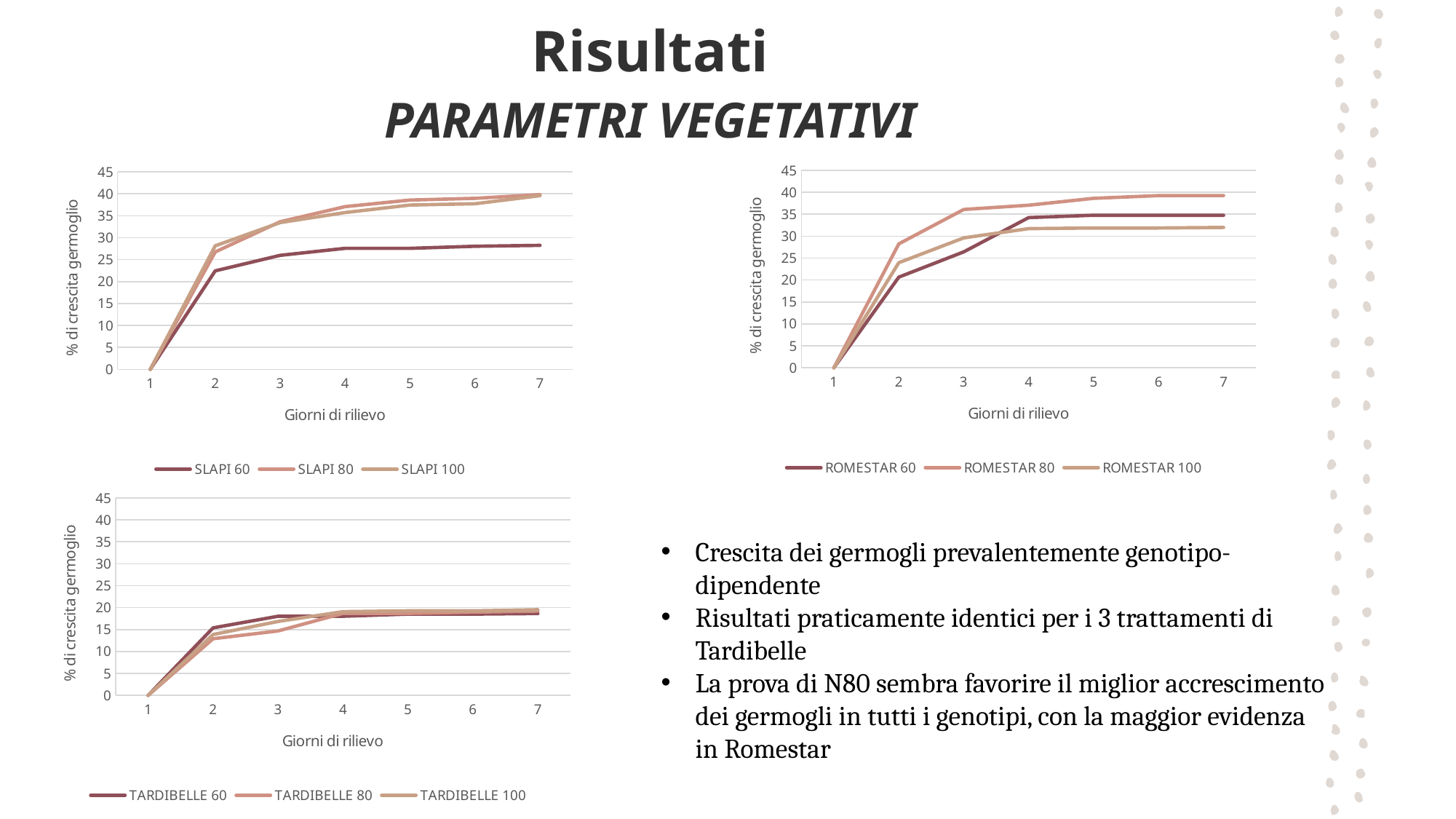
In the top-left chart (SLAPI), which is larger on day 4: SLAPI 80 or SLAPI 60? SLAPI 80 In the top-right chart (ROMESTAR), which is larger on day 3: ROMESTAR 80 or ROMESTAR 60? ROMESTAR 80 In the top-left chart (SLAPI), which series has the lowest value on day 7? SLAPI 60 How many days (x-axis points) are shown on the bottom-left chart (TARDIBELLE)? 7 How many series does the legend of the top-right chart (ROMESTAR) list? 3 In the bottom-left chart (TARDIBELLE), is the value for TARDIBELLE 80 on day 7 greater or less than 25? less What kind of chart is the top-left chart with the SLAPI legend? line chart In the top-right chart (ROMESTAR), which series has the highest value on day 7? ROMESTAR 80 In the top-left chart (SLAPI), is the value for SLAPI 60 on day 7 greater or less than 30? less In the top-right chart (ROMESTAR), is the value for ROMESTAR 80 on day 7 greater or less than 35? greater In the top-right chart (ROMESTAR), which series has the lowest value on day 7? ROMESTAR 100 In the bottom-left chart (TARDIBELLE), what is the value for TARDIBELLE 60 on day 1? 0